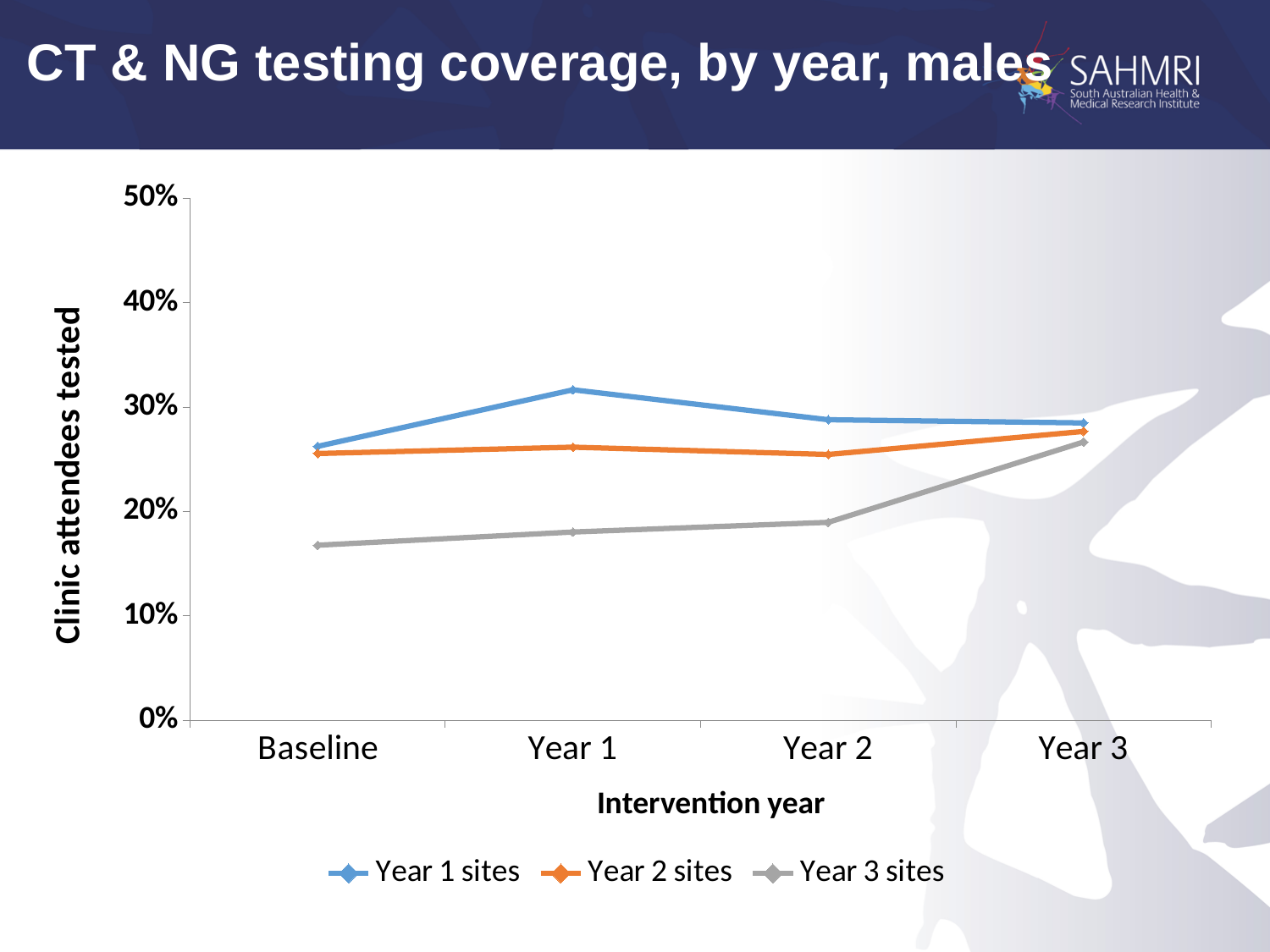
What is the title of the y axis? Clinic attendees tested How many intervention year categories are shown on the x axis? 4 At which intervention year does the Year 3 sites series have its lowest value? Baseline Is the value for Year 3 sites at Baseline greater or less than 20%? less At Baseline, which series has the higher value: Year 1 sites or Year 3 sites? Year 1 sites What is the title of the chart on the slide? CT & NG testing coverage, by year, males What kind of chart is shown on the slide? Line chart Is the value for Year 2 sites at Year 2 greater or less than 30%? less How many series does the legend list? 3 At which intervention year does the Year 1 sites series reach its highest value? Year 1 Does the Year 3 sites series rise or fall from Baseline to Year 3? Rise Is the value for Year 1 sites at Year 1 greater or less than 30%? greater